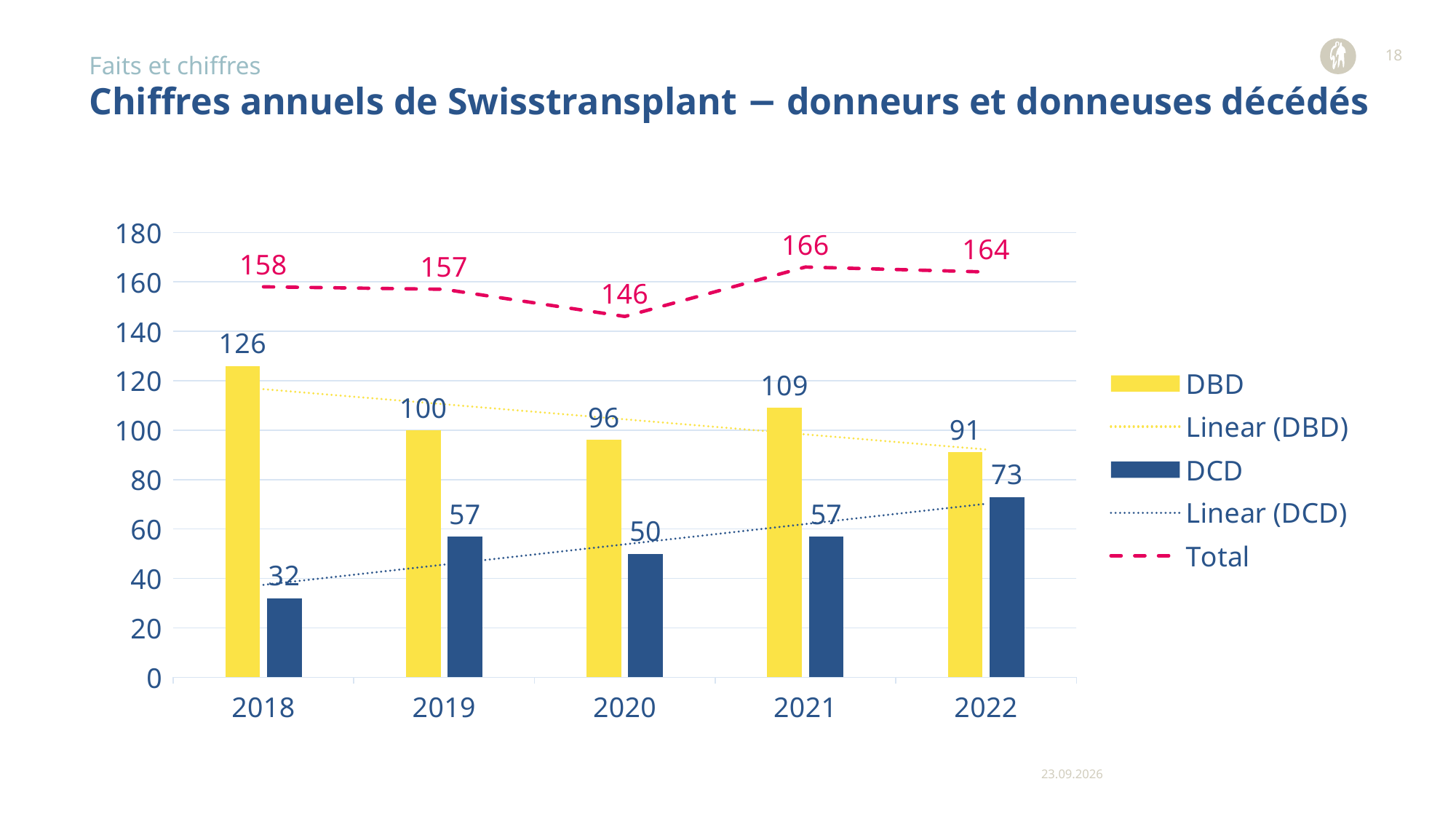
How many entries does the legend list? 5 What is the difference between the DBD and DCD values in 2021? 52 Which is larger, the DBD value for 2019 or the DBD value for 2020? DBD value for 2019 Which year has the highest DBD value? 2018 Is the DCD value for 2020 greater or less than 60? less Which year has the lowest DCD value? 2018 What is the DBD value for 2018? 126 Do the DCD values generally rise or fall from 2018 to 2022? rise What is the Total value for 2020? 146 What is the DCD value for 2022? 73 Which year has the highest Total value? 2021 How many years are shown on the x axis? 5